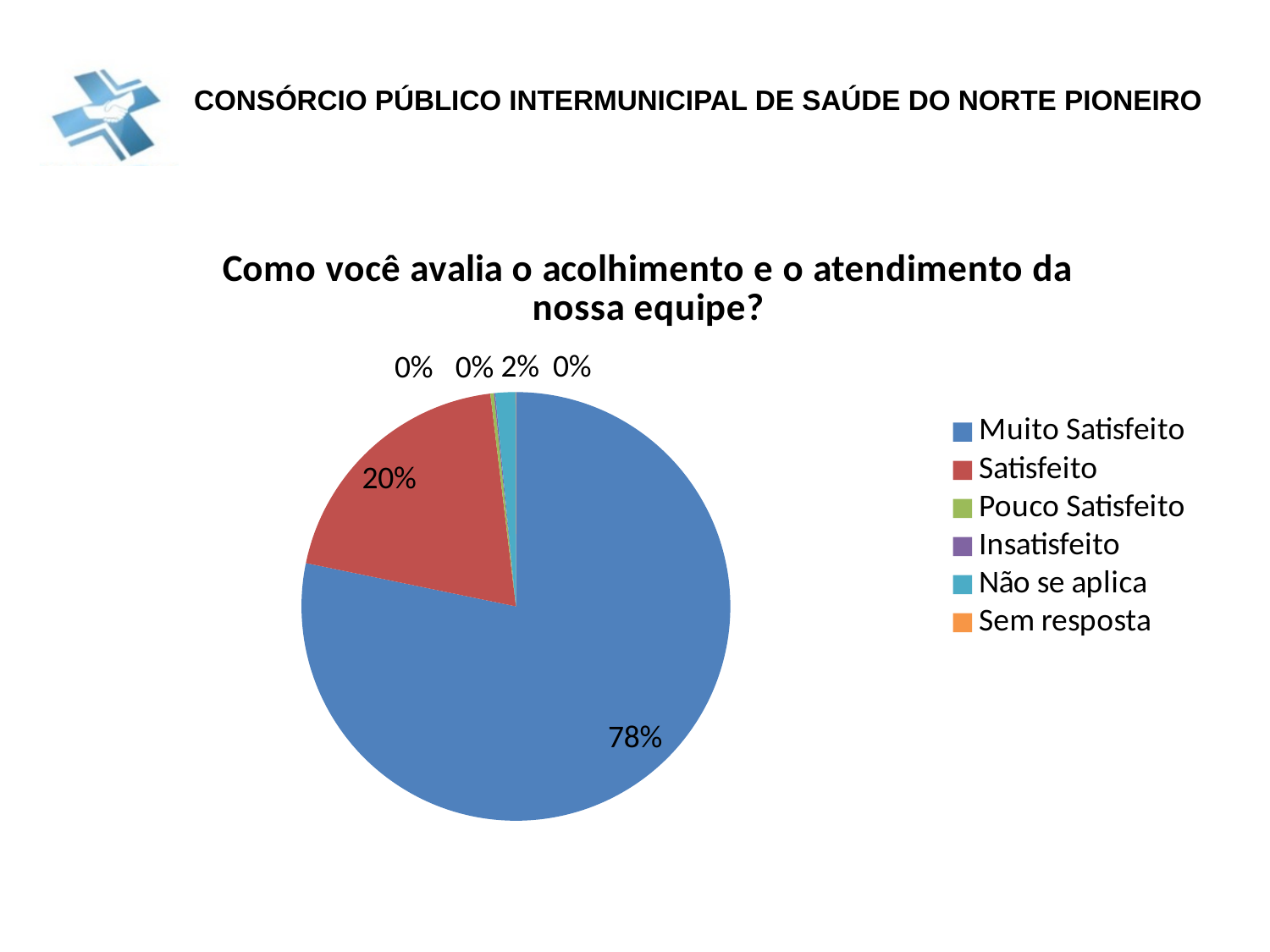
What is the combined share of "Muito Satisfeito" and "Satisfeito"? 98% What percentage of respondents answered "Satisfeito"? 20% What is the title of the chart? Como você avalia o acolhimento e o atendimento da nossa equipe? What kind of chart is shown on the slide? pie chart What is the difference in percentage points between "Muito Satisfeito" and "Satisfeito"? 58 What percentage is shown for "Insatisfeito"? 0% What percentage is shown for "Não se aplica"? 2% Which category has the largest share of the pie? Muito Satisfeito What colour is the "Satisfeito" slice? red How many categories does the legend list? 6 Which is larger, the share for "Satisfeito" or the share for "Não se aplica"? Satisfeito What percentage of respondents answered "Muito Satisfeito"? 78%